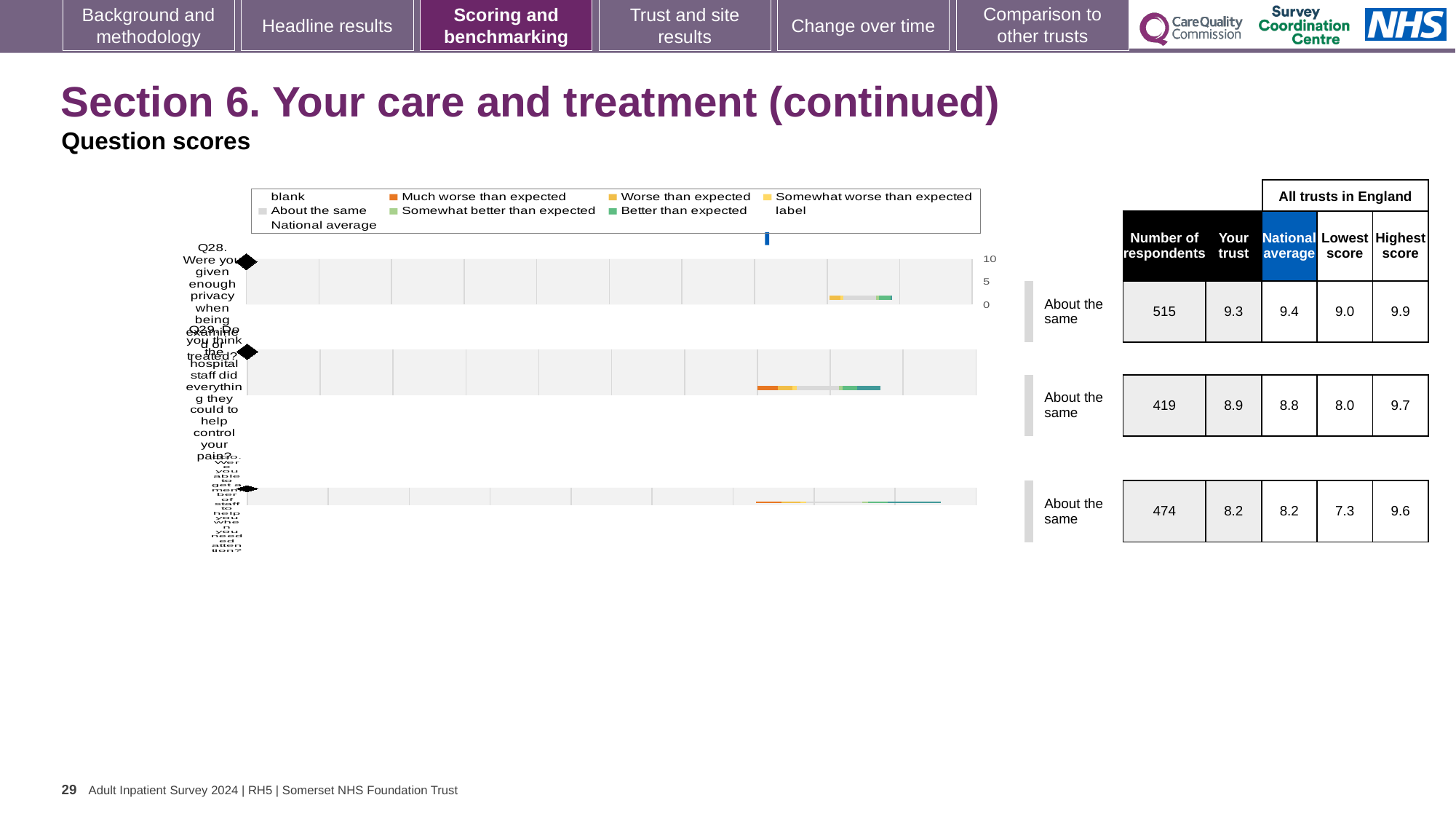
For Q29, which is larger: the 'Your trust' score or the national average? Your trust What benchmark category is shown for Q30? About the same What is the 'Your trust' score for Q29? 8.9 What is the national average score for Q28? 9.4 What is the lowest score across all trusts in England for Q29? 8.0 What is the difference between the highest score and the lowest score for Q28? 0.9 Which question has the lowest number of respondents? Q29 What is the highest score across all trusts in England for Q30? 9.6 How many questions are plotted on the slide? 3 What is the 'Your trust' score for Q28? 9.3 Which question has the highest 'Your trust' score? Q28 How many respondents are shown for Q28? 515